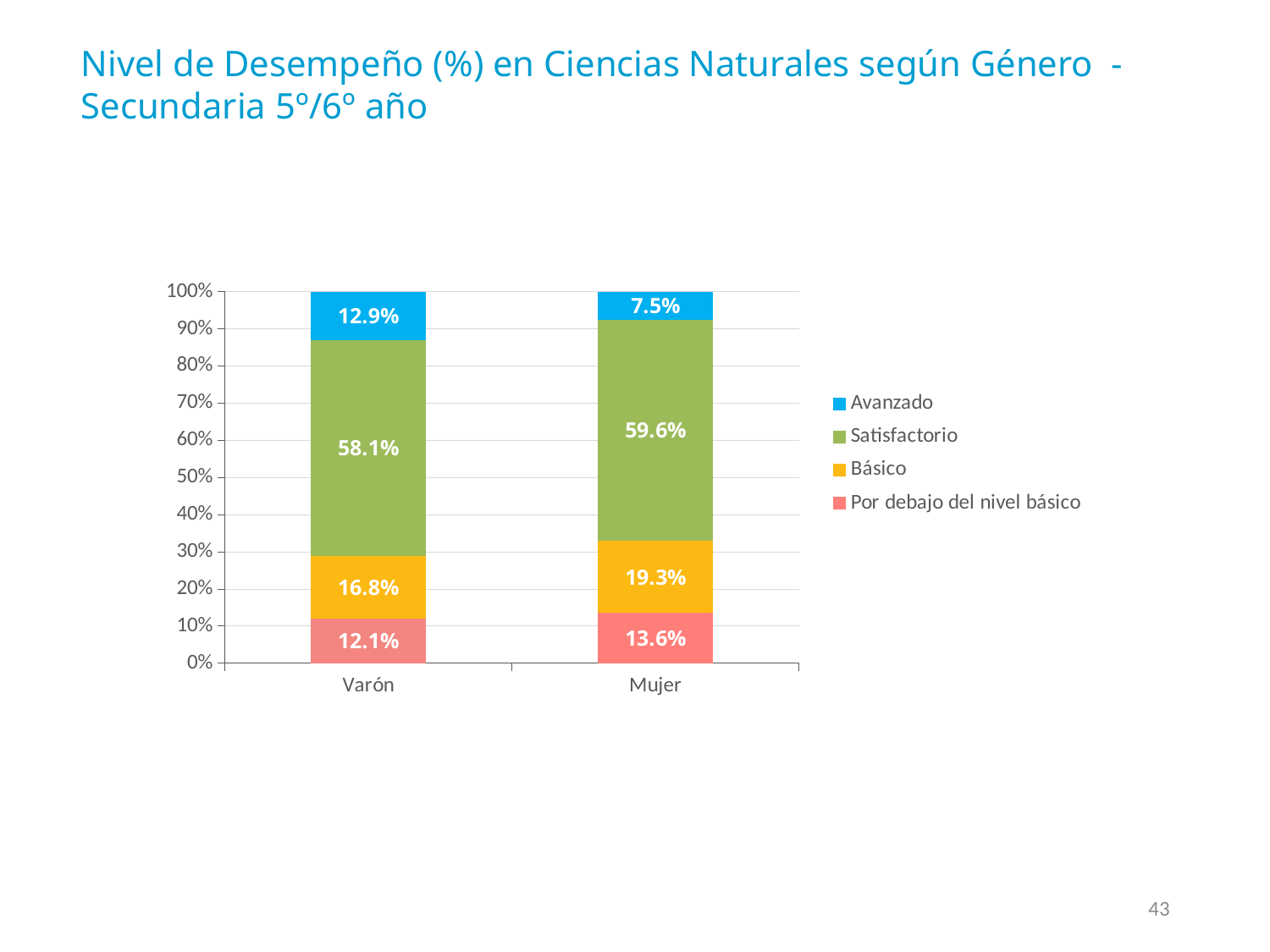
What is the Por debajo del nivel básico value for Varón? 12.1% What is the Satisfactorio value for Mujer? 59.6% Which gender has the higher Básico value? Mujer What is the difference between the Avanzado values for Varón and Mujer? 5.4% What is the Básico value for Mujer? 19.3% How many series does the legend list? 4 What is the difference between the Básico values for Mujer and Varón? 2.5% What kind of chart is shown on the slide? Stacked bar chart Which performance level has the largest share for Varón? Satisfactorio What is the Avanzado value for Varón? 12.9% Which gender has the higher Avanzado value? Varón Which performance level has the smallest share for Mujer? Avanzado